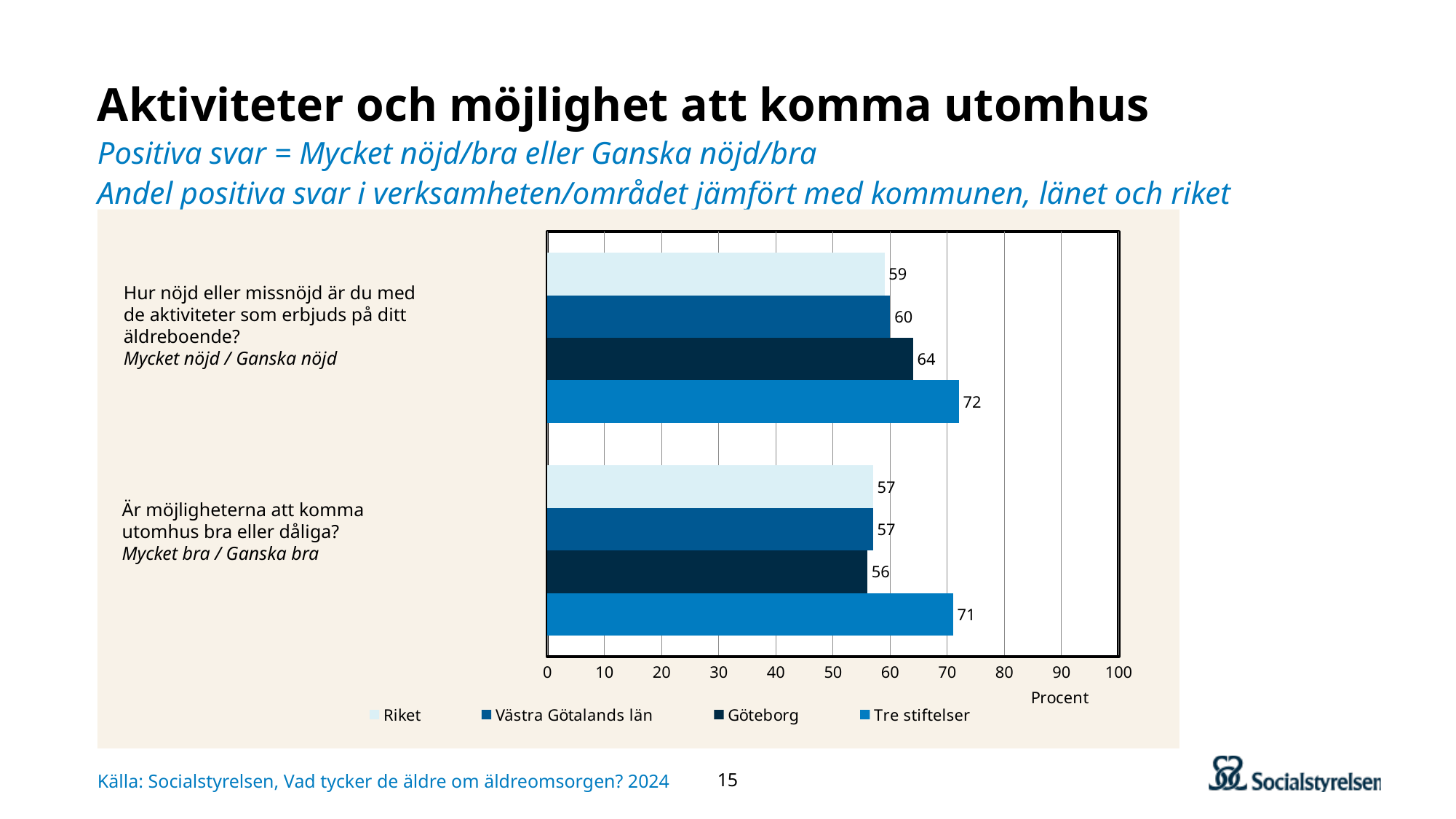
Which is larger: the value for Göteborg on the activities question or the value for Göteborg on the outdoors question? The activities question (64) What is the value for Göteborg on the question about satisfaction with activities offered at the care home? 64 Which series has the lowest value on the question about satisfaction with activities offered at the care home? Riket What unit is shown on the horizontal axis of the chart? Procent How many series does the legend list? 4 What is the difference between Tre stiftelser and Göteborg on the question about satisfaction with activities offered at the care home? 8 What is the value for Västra Götalands län on the question about the possibilities to get outdoors? 57 What is the difference between Tre stiftelser and Göteborg on the question about the possibilities to get outdoors? 15 What kind of chart is shown on the slide? Bar chart What is the value for Tre stiftelser on the question about satisfaction with activities offered at the care home (Hur nöjd eller missnöjd är du med de aktiviteter som erbjuds på ditt äldreboende?)? 72 What is the value for Riket on the question about the possibilities to get outdoors (Är möjligheterna att komma utomhus bra eller dåliga?)? 57 Which series has the highest value on the question about the possibilities to get outdoors? Tre stiftelser